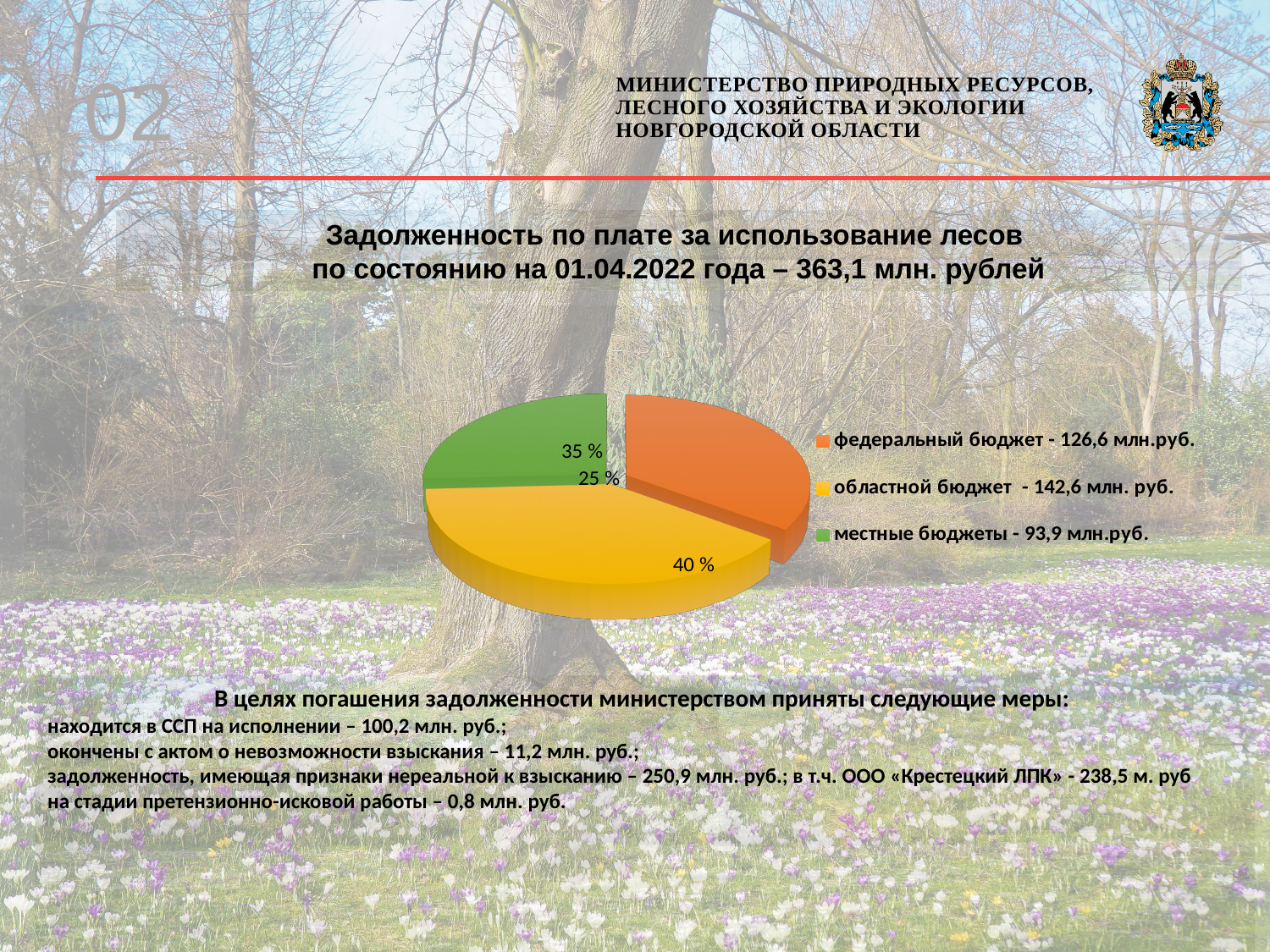
According to the legend, what is the debt amount for the федеральный бюджет? 126,6 млн.руб. Which budget has the smallest share of the debt in the pie chart? местные бюджеты What kind of chart is shown on the slide? Pie chart According to the legend, what is the debt amount for местные бюджеты? 93,9 млн.руб. Which is larger: the debt for the федеральный бюджет or for the областной бюджет? областной бюджет How many slices does the pie chart have? 3 What colour is the slice for местные бюджеты in the pie chart? Green Which budget has the largest share of the debt in the pie chart? областной бюджет What is the difference between the debt for the областной бюджет and the федеральный бюджет? 16,0 млн. руб. According to the legend, what is the debt amount for the областной бюджет? 142,6 млн. руб. How many entries does the legend of the pie chart list? 3 What percentage share of the pie is labelled on the yellow slice (областной бюджет)? 40 %